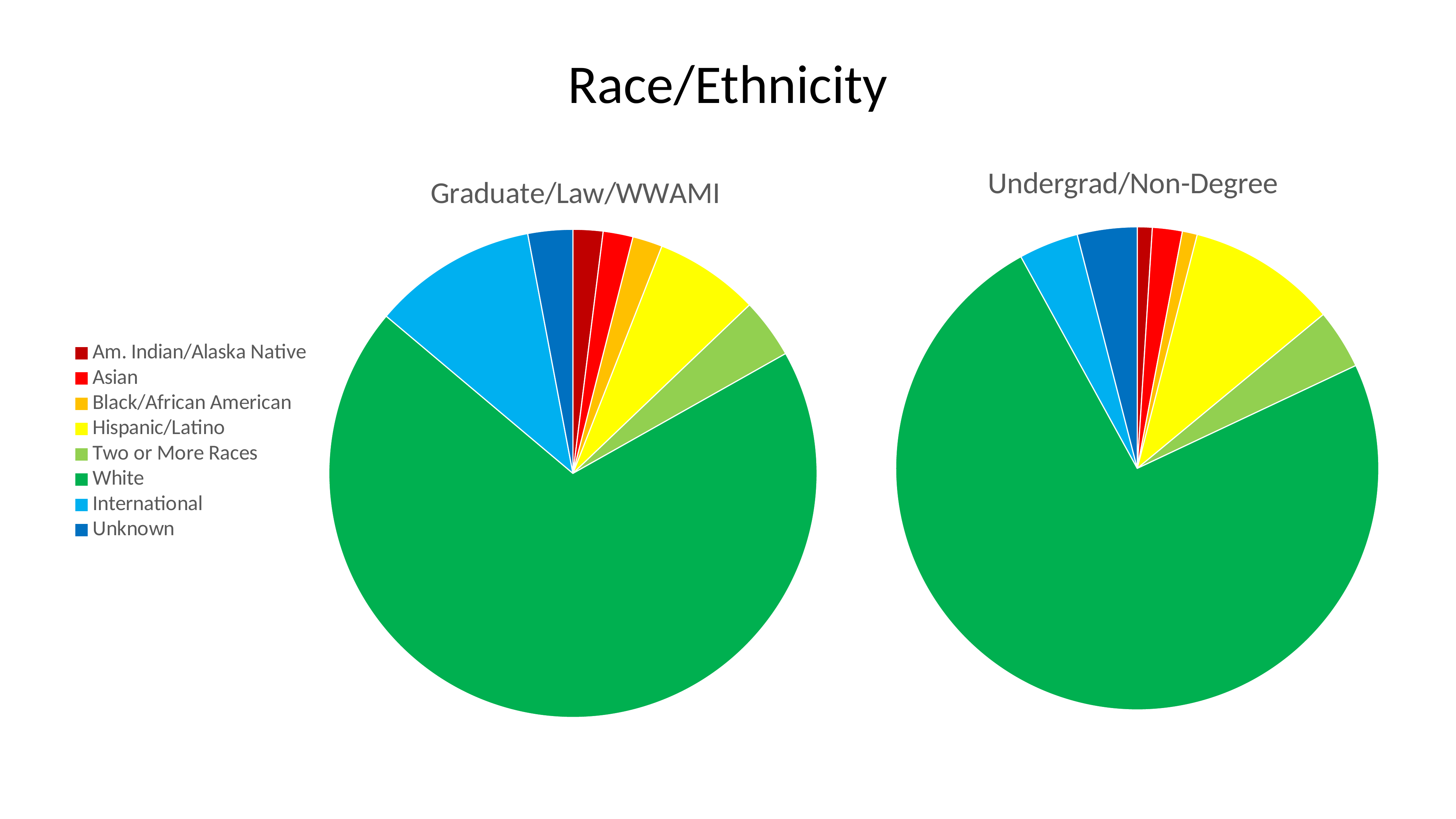
In the Graduate/Law/WWAMI chart, which slice is larger, International or Unknown? International In the Undergrad/Non-Degree chart, which slice is larger, Hispanic/Latino or International? Hispanic/Latino In the Undergrad/Non-Degree chart, which slice is larger, Hispanic/Latino or Two or More Races? Hispanic/Latino What kind of chart is the Undergrad/Non-Degree chart? pie chart In the Graduate/Law/WWAMI chart, which category has the largest slice? White What kind of chart is the Graduate/Law/WWAMI chart? pie chart What colour represents the White category in the charts? green What is the overall title of the slide's charts? Race/Ethnicity How many race/ethnicity categories does the legend list? 8 In the Undergrad/Non-Degree chart, which category has the largest slice? White